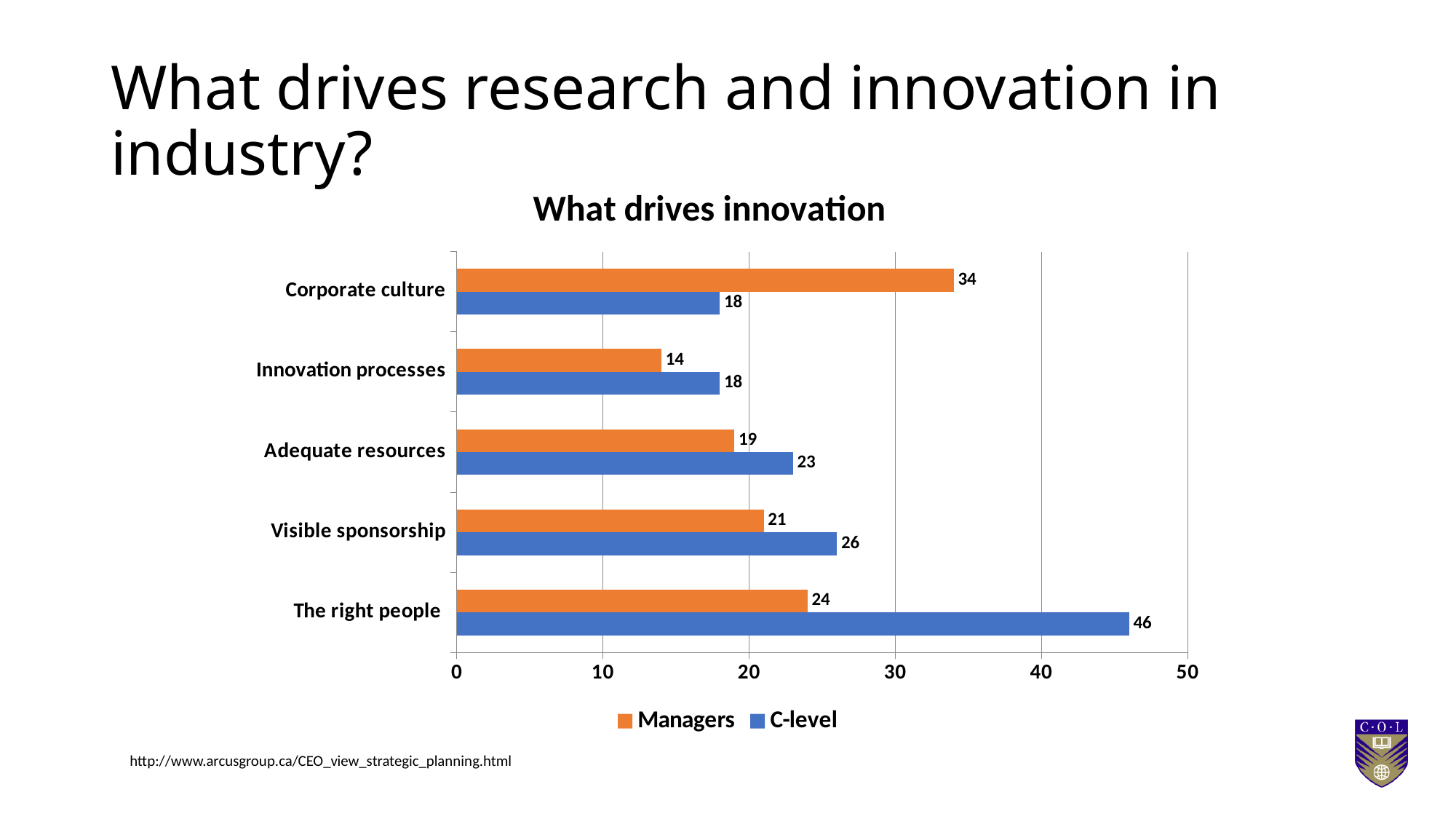
What is the Managers value for Corporate culture? 34 What is the C-level value for The right people? 46 How many series does the legend list? 2 Which category has the lowest Managers value? Innovation processes What is the C-level value for Adequate resources? 23 How many categories are shown on the chart? 5 Which is larger for Visible sponsorship, the Managers value or the C-level value? C-level What is the title of the chart? What drives innovation Is the Managers value for Corporate culture greater or less than 30? greater What is the difference between the C-level and Managers values for The right people? 22 What kind of chart is shown on the slide? bar chart Which category has the highest C-level value? The right people